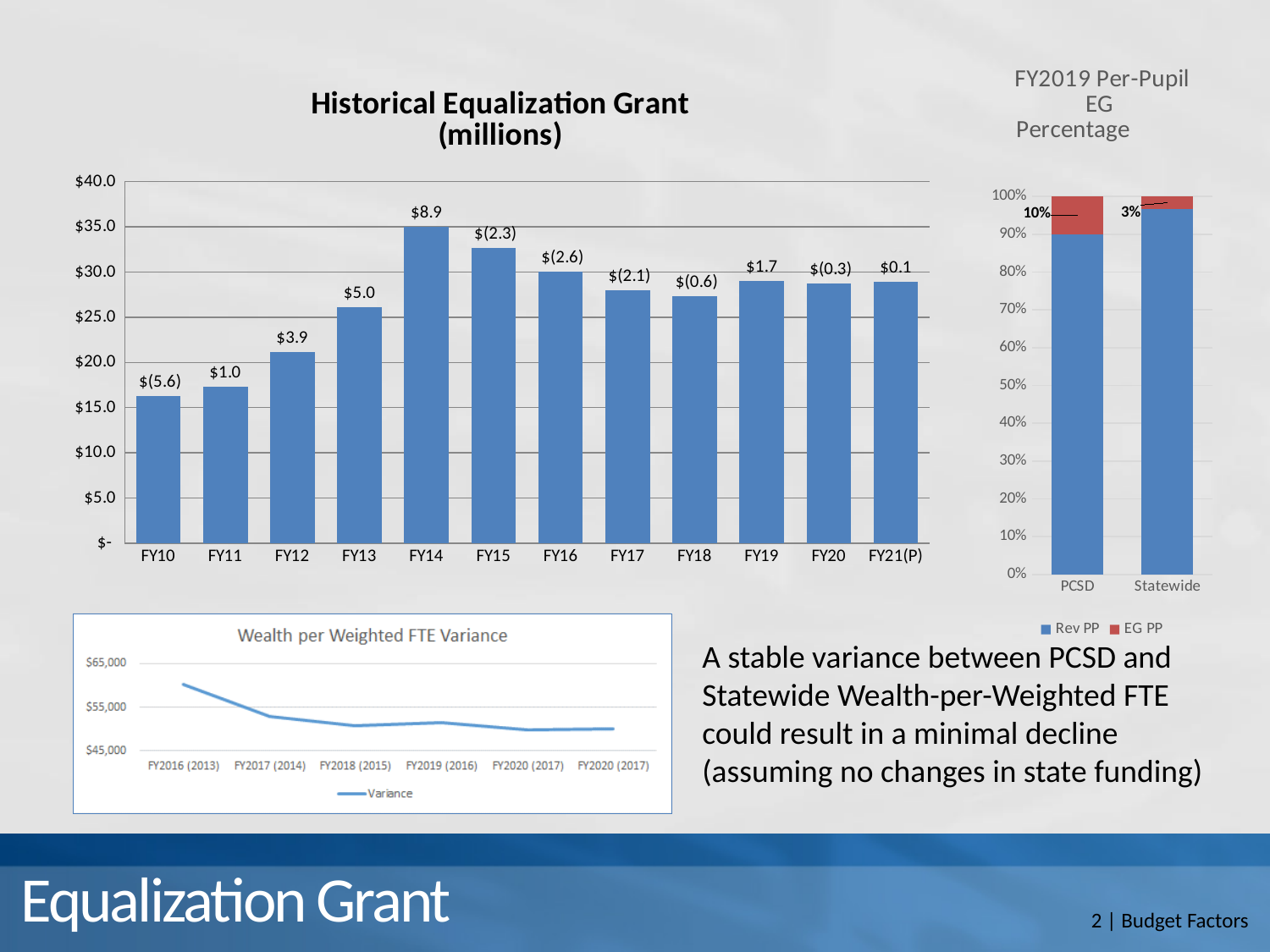
In the Historical Equalization Grant (millions) chart, what data label is printed above the FY10 bar? $(5.6) How many fiscal years are shown on the x axis of the Historical Equalization Grant (millions) chart? 12 How many series does the legend of the FY2019 Per-Pupil EG Percentage chart list? 2 In the Historical Equalization Grant (millions) chart, which fiscal year has the shortest bar? FY10 In the Historical Equalization Grant (millions) chart, what data label is printed above the FY14 bar? $8.9 In the FY2019 Per-Pupil EG Percentage chart, which has the larger EG PP share, PCSD or Statewide? PCSD In the Historical Equalization Grant (millions) chart, is the value for FY14 greater or less than $30.0? greater In the Historical Equalization Grant (millions) chart, is the value for FY10 greater or less than $20.0? less In the Wealth per Weighted FTE Variance chart at the bottom left, do the values rise or fall along the x axis? fall In the Historical Equalization Grant (millions) chart, which fiscal year has the tallest bar? FY14 In the FY2019 Per-Pupil EG Percentage chart, what is the EG PP percentage for PCSD? 10% In the FY2019 Per-Pupil EG Percentage chart, what is the EG PP percentage for Statewide? 3%